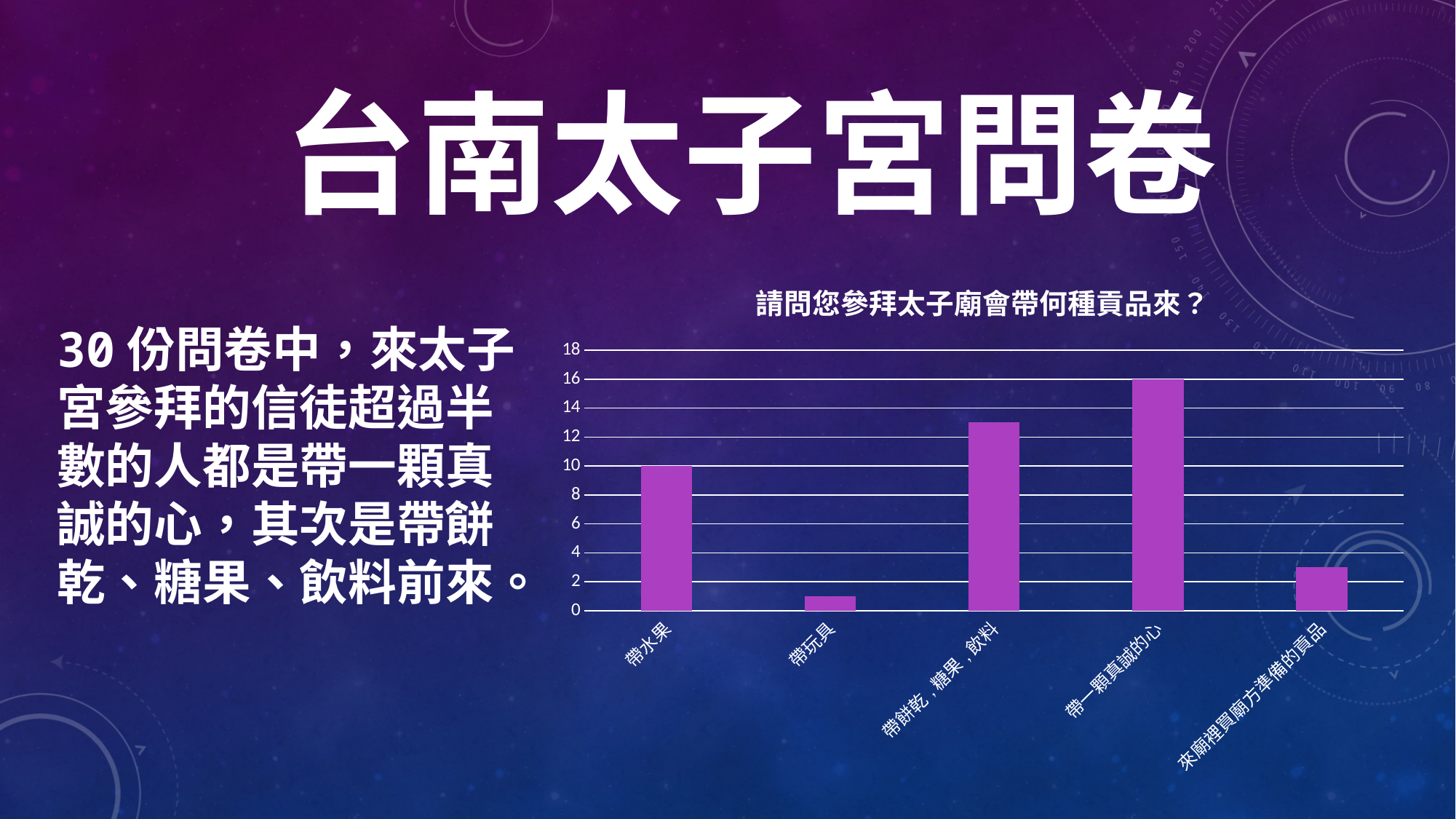
How many categories are shown on the x axis? 5 What is the value for 帶一顆真誠的心? 16 Which is larger, the value for 帶餅乾，糖果，飲料 or the value for 帶水果? 帶餅乾，糖果，飲料 What kind of chart is shown on the slide? bar chart What is the title of the chart? 請問您參拜太子廟會帶何種貢品來？ Which category has the highest value? 帶一顆真誠的心 Is the value for 帶玩具 greater or less than 2? less Is the value for 來廟裡買廟方準備的貢品 greater or less than 4? less Which category has the lowest value? 帶玩具 What is the difference between the values for 帶一顆真誠的心 and 帶水果? 6 What is the value for 帶水果? 10 Is the value for 帶餅乾，糖果，飲料 greater or less than 12? greater